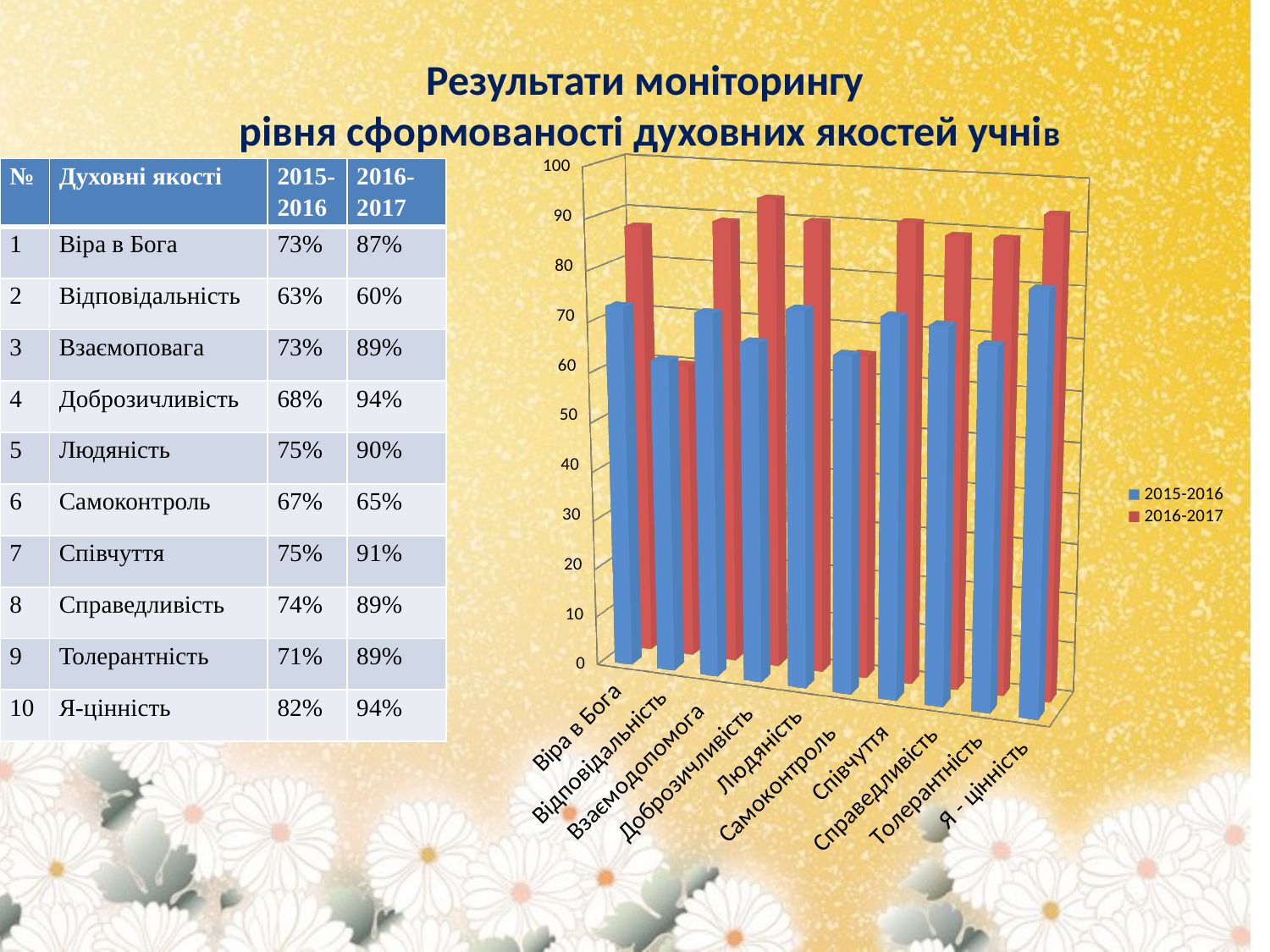
What is the 2016-2017 value for Віра в Бога? 87% What is the 2015-2016 value for Толерантність? 71% Is the 2015-2016 value for Відповідальність greater or less than 70? less For Самоконтроль, which series has the larger value, 2015-2016 or 2016-2017? 2015-2016 How many series does the chart legend list? 2 What kind of chart is shown on the slide? bar chart Which category has the lowest 2016-2017 value? Відповідальність Which series is shown in blue in the chart? 2015-2016 Which category has the highest 2015-2016 value? Я-цінність How many categories are plotted along the x axis of the chart? 10 By how much did the value for Людяність increase from 2015-2016 to 2016-2017? 15% Is the 2016-2017 value for Співчуття greater or less than 80? greater